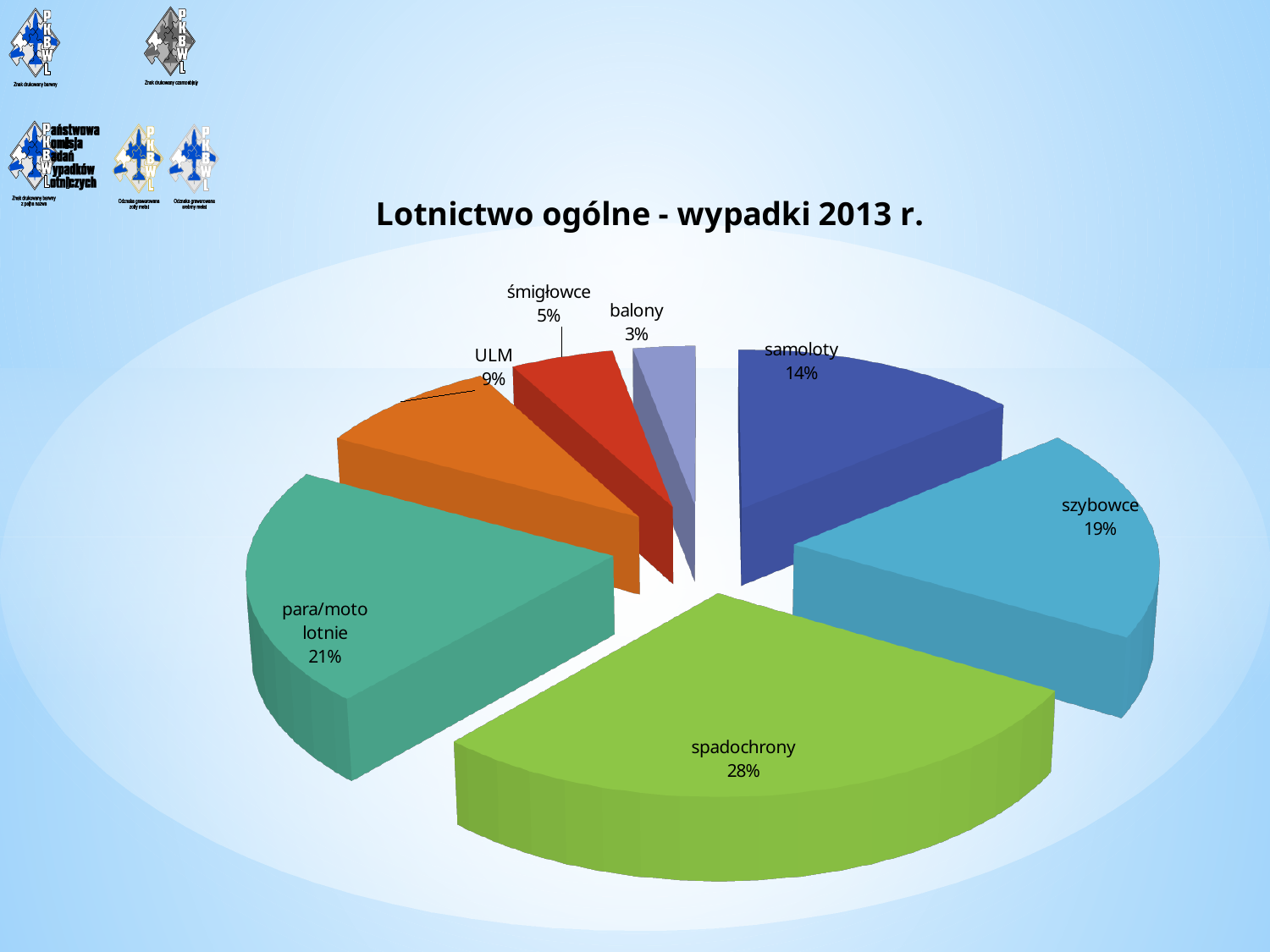
What share of the pie does spadochrony have? 28% Which category has the largest share of the pie? spadochrony Which is larger, the share for para/moto lotnie or the share for szybowce? para/moto lotnie What is the value shown for para/moto lotnie? 21% What is the value shown for balony? 3% How many categories are shown in the pie chart? 7 What is the value shown for ULM? 9% What is the value shown for szybowce? 19% What is the difference between the shares of szybowce and samoloty? 5% Which category has the smallest share of the pie? balony What kind of chart is shown on the slide? pie chart What is the title of the chart? Lotnictwo ogólne - wypadki 2013 r.